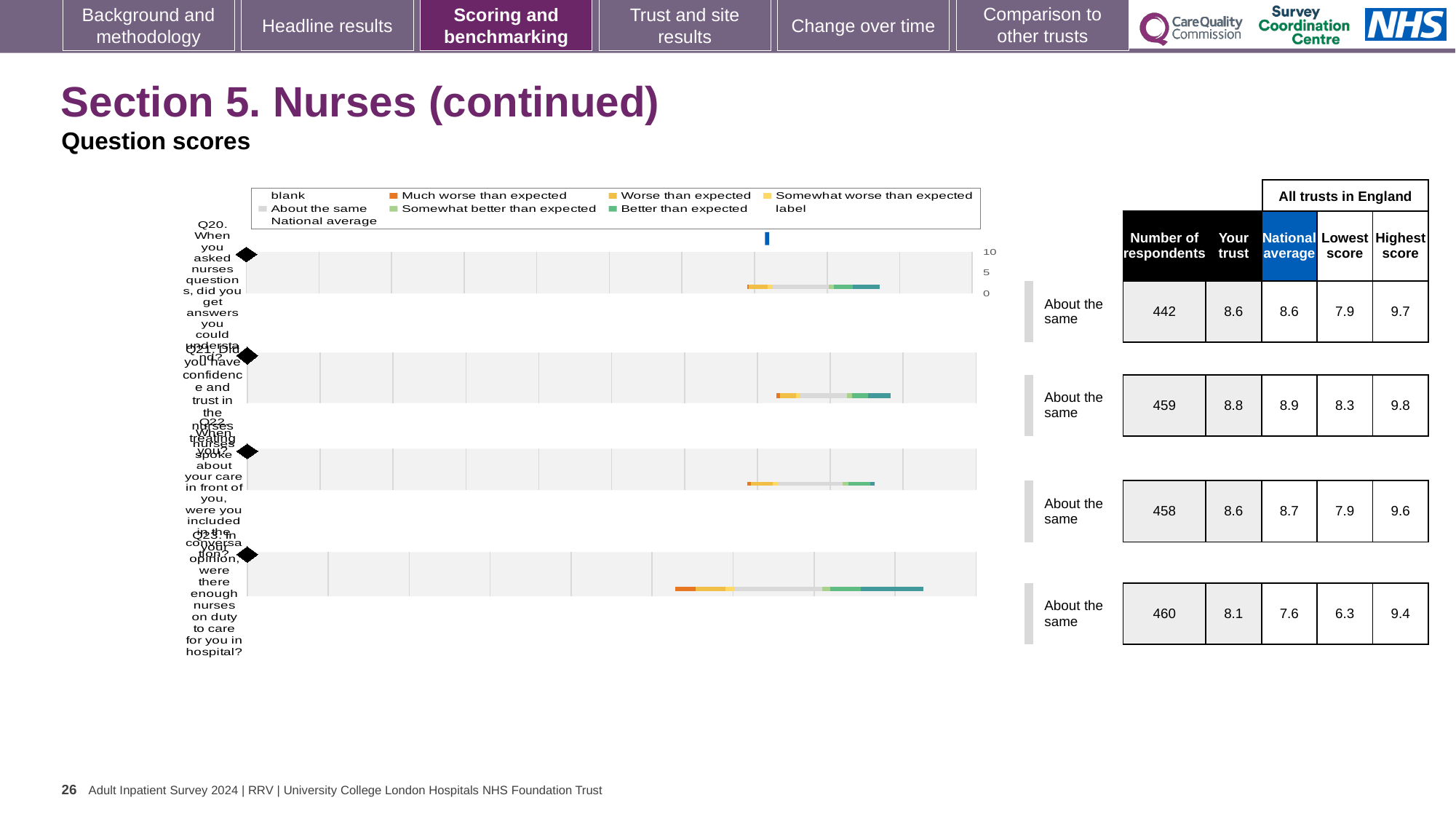
In the table next to the Q21 chart, what is the 'Your trust' score? 8.8 In the table next to the Q22 chart, what is the national average score? 8.7 In the table next to the Q21 chart, what is the highest score among all trusts in England? 9.8 Which question (Q20, Q21, Q22 or Q25) has the lowest 'Lowest score' value in the tables? Q25 In the table next to the Q20 chart, what is the number of respondents? 442 What benchmark category is shown beside each of the four question charts? About the same What kind of chart is used to show the question scores for Q20, Q21, Q22 and Q25? bar chart For Q25, which is larger in the table: the 'Your trust' score or the national average? Your trust How many question charts (Q20, Q21, Q22, Q25) are shown on the slide? 4 Which question (Q20, Q21, Q22 or Q25) has the highest 'Your trust' score in the tables? Q21 In the table next to the Q25 chart, what is the lowest score among all trusts in England? 6.3 For Q25, what is the difference between the 'Your trust' score and the national average in the table? 0.5